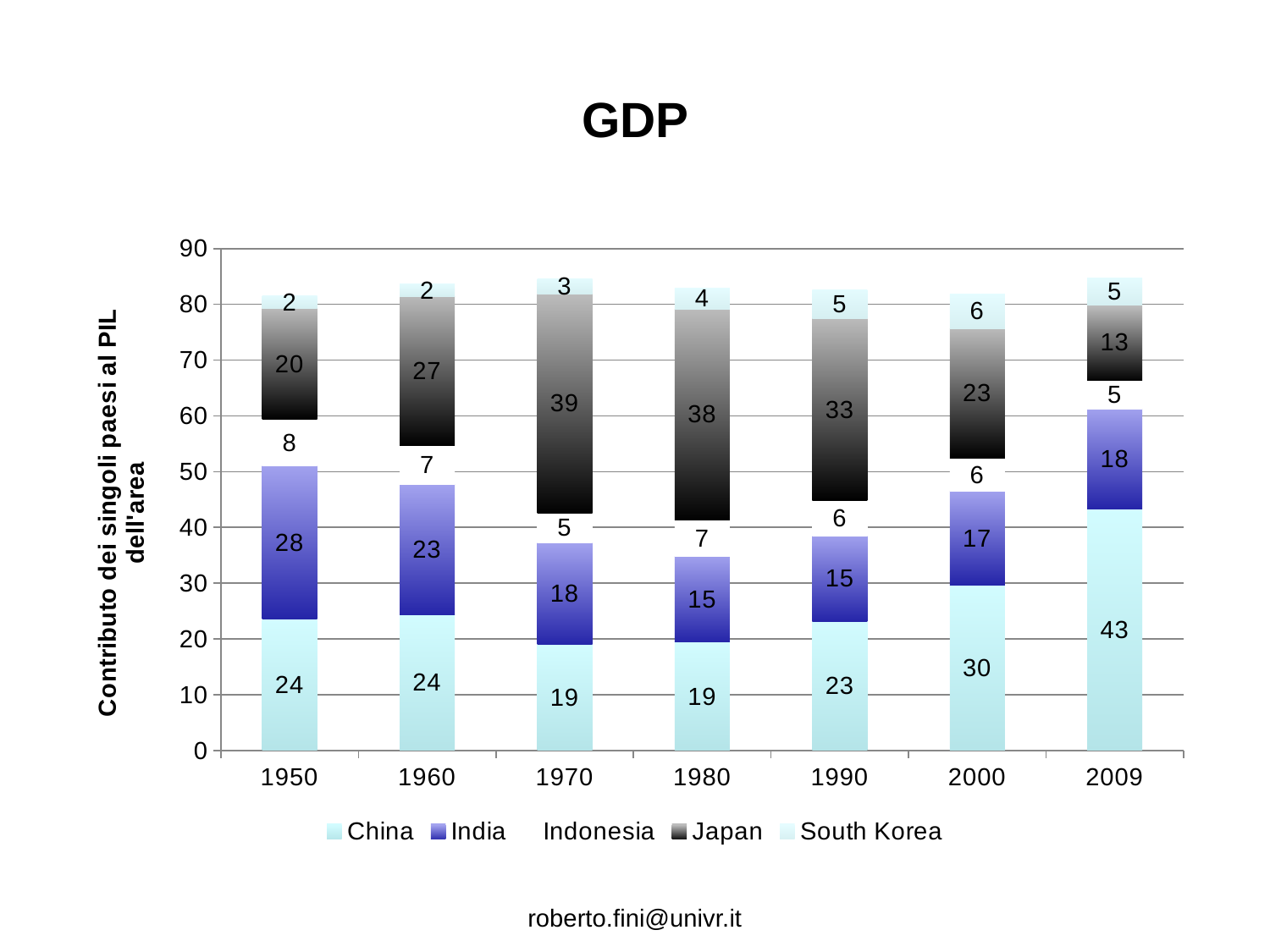
What is the value for India in 1950? 28 Which is larger, the China value in 2000 or the Japan value in 2000? China What kind of chart is shown on the slide? Stacked bar chart What is the value for Japan in 1970? 39 How many years are shown on the x axis? 7 What is the difference between the Japan value in 1970 and the Japan value in 2009? 26 How many series does the legend list? 5 What is the value for South Korea in 2000? 6 In which year is the value for Japan lowest? 2009 What is the total of the stacked bar for 1950? 82 What is the value for China in 2009? 43 In which year is the value for China highest? 2009